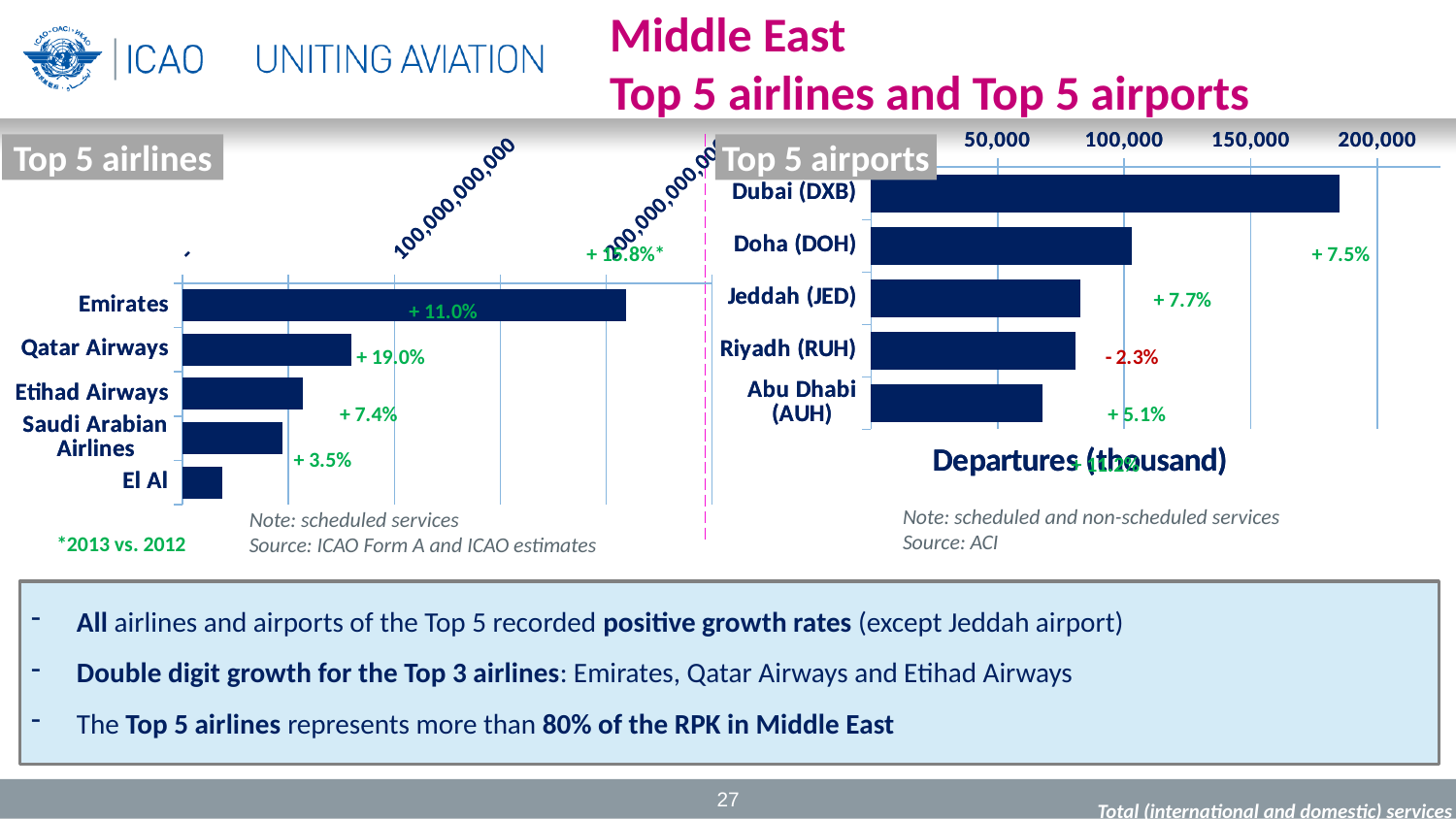
In the Top 5 airlines chart, which airline has the longest bar? Emirates In the Top 5 airlines chart, which has the larger value, Qatar Airways or Etihad Airways? Qatar Airways In the Top 5 airlines chart, which airline has the shortest bar? El Al What kind of chart is the Top 5 airlines chart? bar chart In the Top 5 airlines chart, is the value for Qatar Airways greater or less than 100,000,000,000? less In the Top 5 airports chart, which airport has the highest number of departures? Dubai (DXB) How many airlines are shown in the Top 5 airlines chart? 5 What is the axis label shown below the bars in the Top 5 airports chart? Departures (thousand) In the Top 5 airports chart, is the value for Dubai (DXB) greater or less than 150,000? greater In the Top 5 airports chart, is the value for Abu Dhabi (AUH) greater or less than 100,000? less What kind of chart is the Top 5 airports chart? bar chart In the Top 5 airports chart, which airport has the lowest number of departures? Abu Dhabi (AUH)